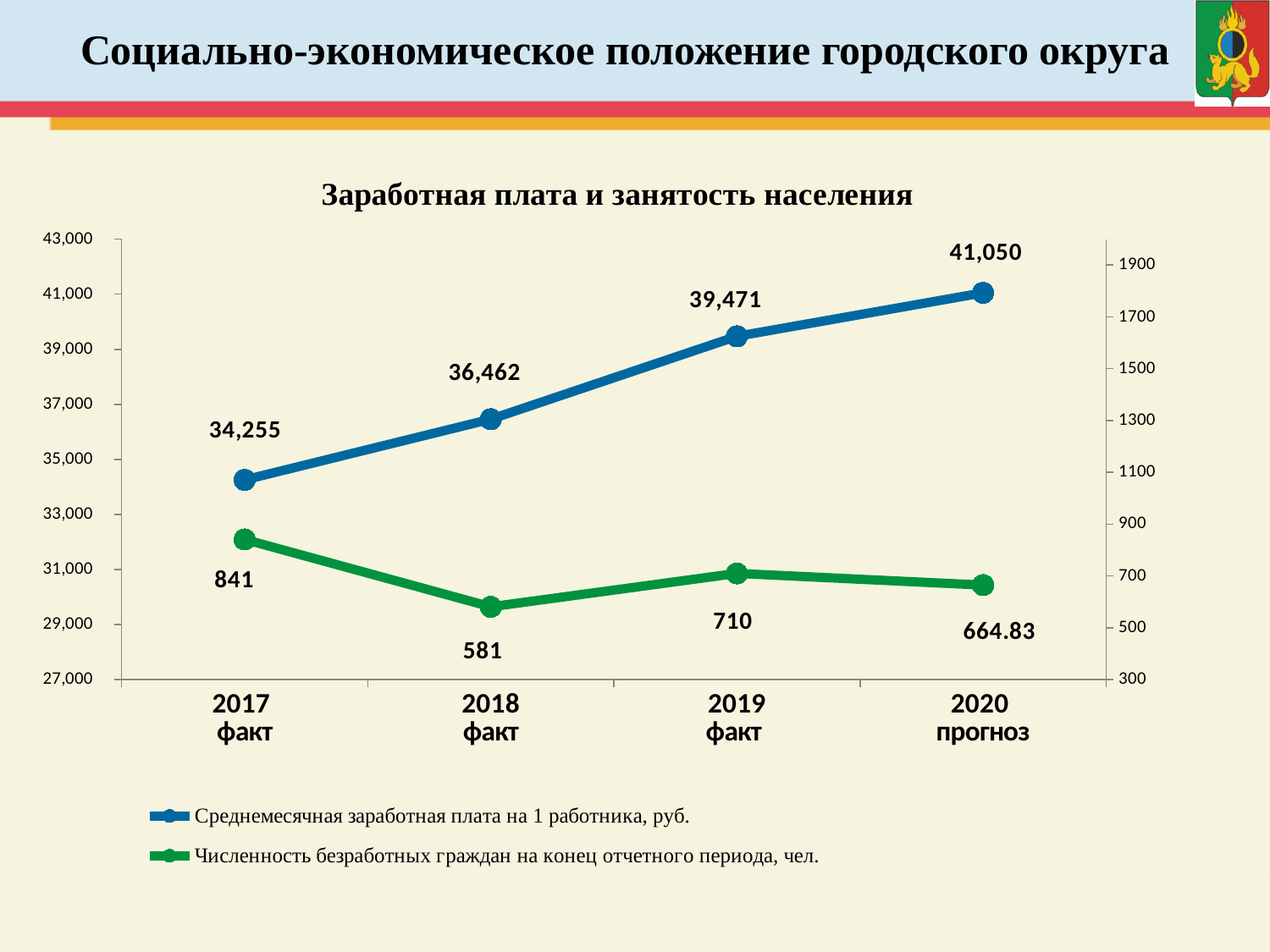
What is the number of unemployed citizens (Численность безработных граждан) for 2018 факт? 581 What is the number of unemployed citizens for 2020 прогноз? 664.83 How does the average monthly salary change from 2017 to 2020 along the x axis? It rises What is the average monthly salary per worker (Среднемесячная заработная плата) for 2017 факт? 34,255 In which year is the number of unemployed citizens lowest? 2018 факт How many series does the legend list? 2 What type of chart is shown on the slide? Line chart What is the forecast value of the average monthly salary for 2020 прогноз? 41,050 Which is larger: the number of unemployed citizens in 2019 факт or in 2020 прогноз? 2019 факт By how much did the average monthly salary increase from 2018 факт to 2019 факт? 3,009 What is the difference in the number of unemployed citizens between 2017 факт and 2018 факт? 260 In which year is the number of unemployed citizens highest? 2017 факт